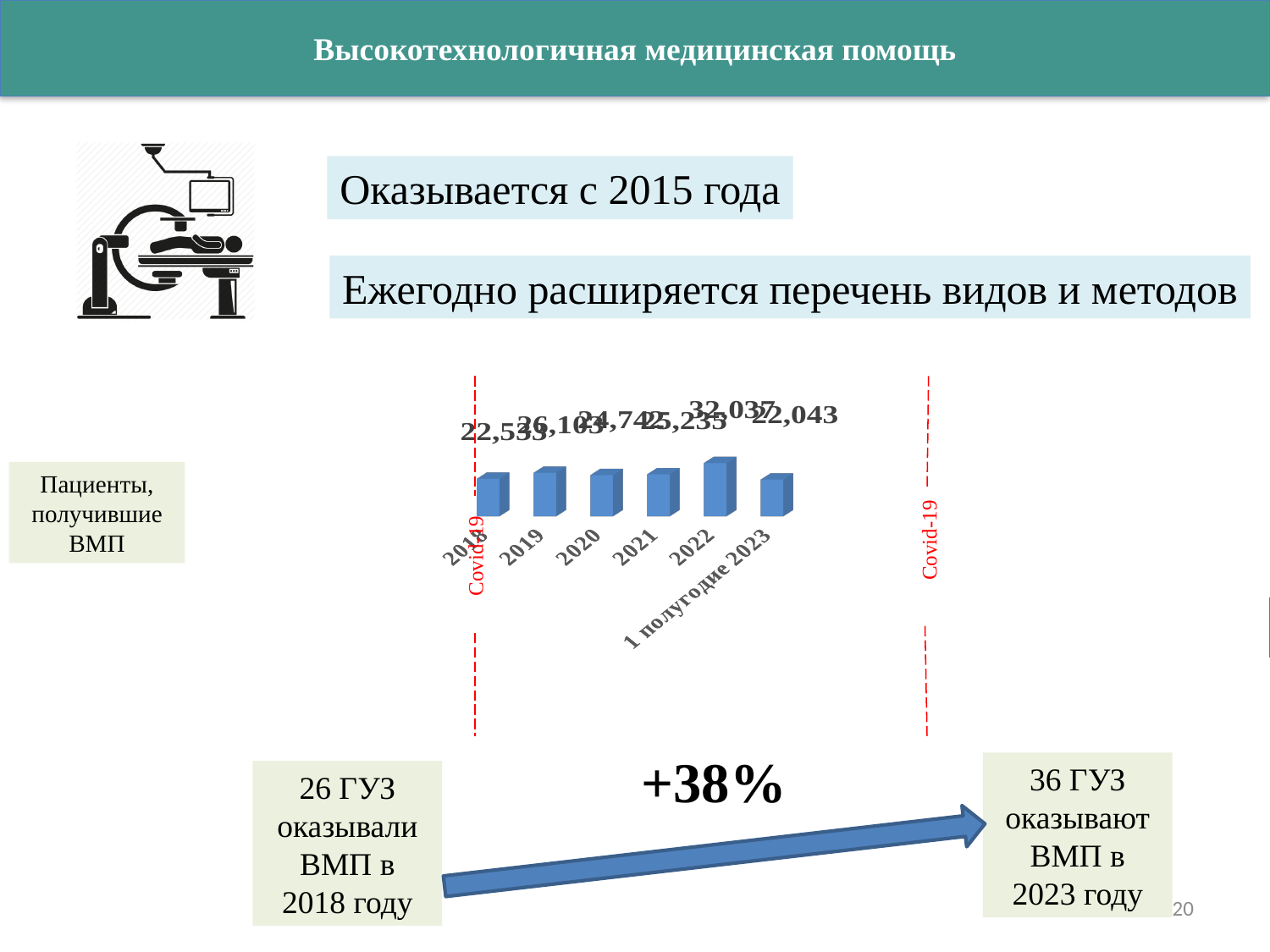
Which category has the lowest value in the chart? 1 полугодие 2023 What is the value shown for 1 полугодие 2023? 22,043 What type of chart is shown on the slide? bar chart What is the label of the first category on the x axis? 2018 Which is larger, the value for 2022 or the value for 2018? 2022 What text is written on the red dashed vertical lines flanking the chart? Covid-19 What is the value shown for 2022? 32,037 How many categories (bars) does the chart show? 6 Does the value rise or fall from 2021 to 2022? rise Which category has the highest value in the chart? 2022 What is the difference between the values for 2022 and 1 полугодие 2023? 9,994